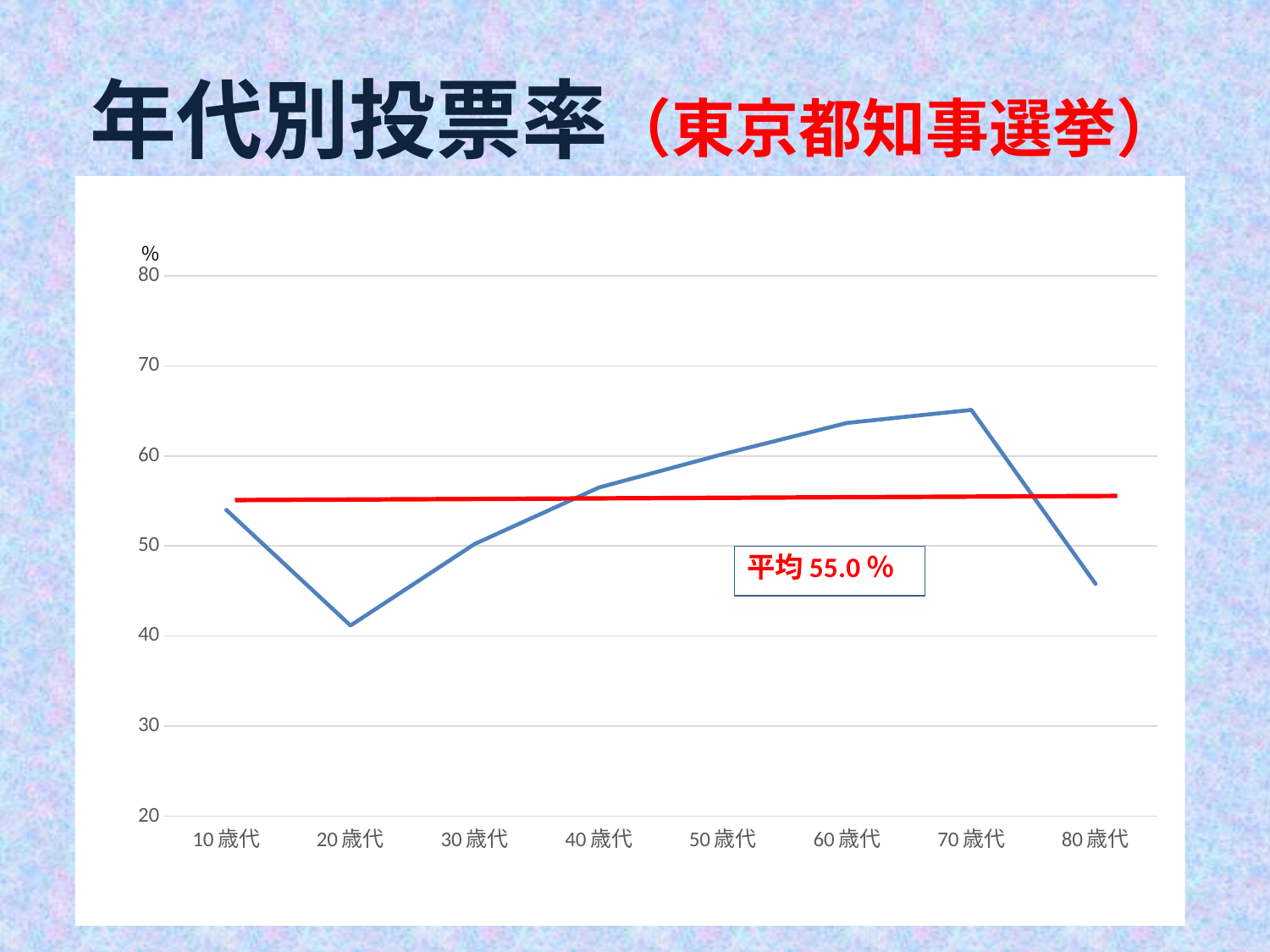
Does the voter turnout rise or fall from 20歳代 to 70歳代? rise How many age groups are plotted along the x axis? 8 Is the voter turnout for 20歳代 greater or less than 50? less What is the title of the slide's chart? 年代別投票率（東京都知事選挙） Is the voter turnout for 70歳代 greater or less than 60? greater What does the red horizontal line on the chart represent? 平均 55.0％ What average value is printed on the chart? 55.0％ Which has the higher voter turnout, 10歳代 or 80歳代? 10歳代 Which age group has the highest voter turnout? 70歳代 Which age group has the lowest voter turnout? 20歳代 Is the voter turnout for 80歳代 greater or less than 50? less What kind of chart is shown on the slide? line chart